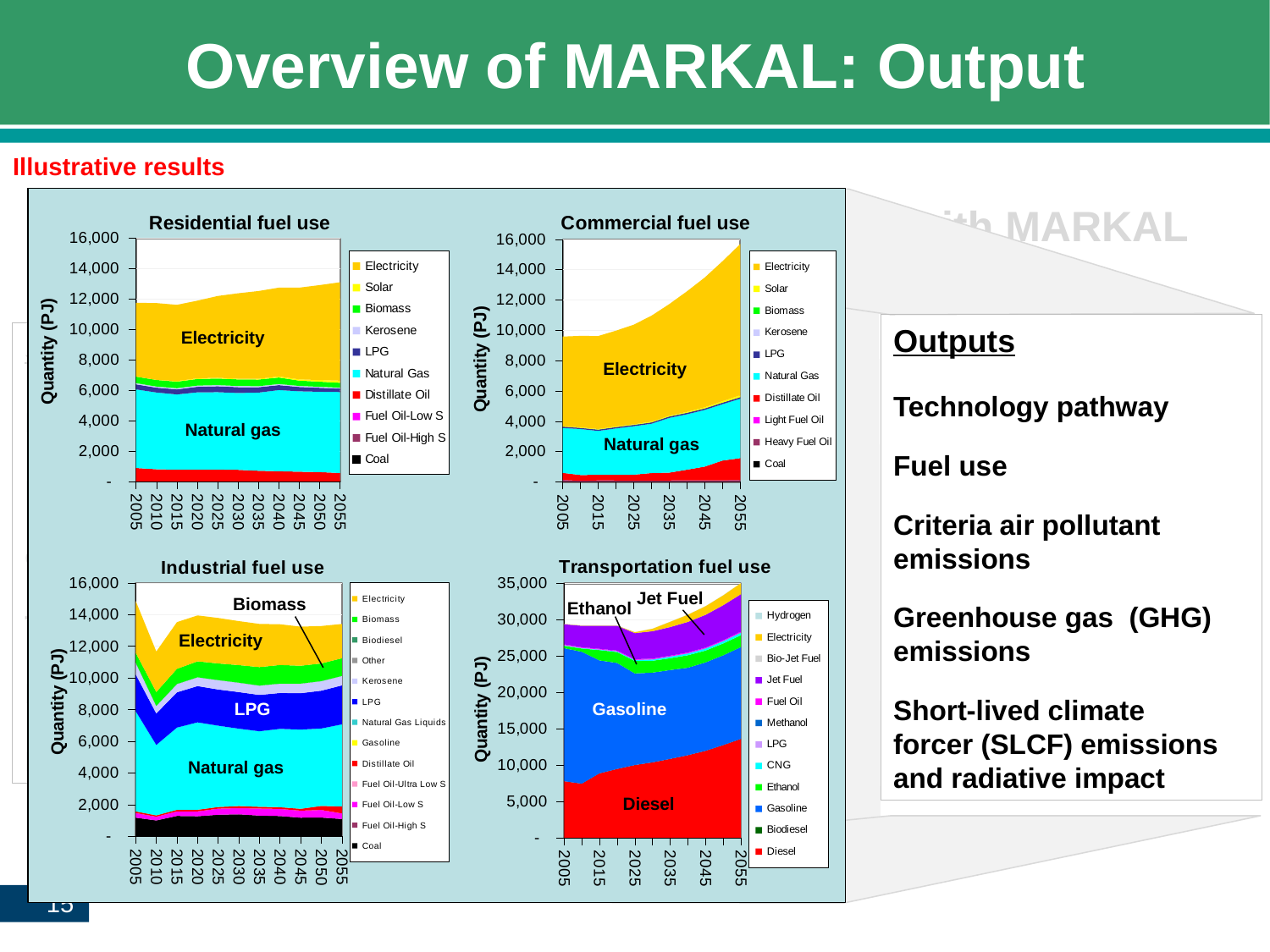
How many series does the legend of the Residential fuel use chart list? 10 What kind of chart is the Residential fuel use chart? Stacked area chart In the Commercial fuel use chart, does total fuel use rise or fall from 2005 to 2055? Rise In the Commercial fuel use chart, is the total fuel use in 2005 greater or less than 10,000 PJ? less How many series does the legend of the Industrial fuel use chart list? 13 What is the y-axis label on the Transportation fuel use chart? Quantity (PJ) In the Industrial fuel use chart, is the total fuel use in 2005 greater or less than 12,000 PJ? greater In the Commercial fuel use chart, is the total fuel use in 2055 greater or less than 14,000 PJ? greater How many fuel use charts are shown on the slide? 4 How many series does the legend of the Transportation fuel use chart list? 12 What is the title of the chart in the bottom-left of the slide? Industrial fuel use